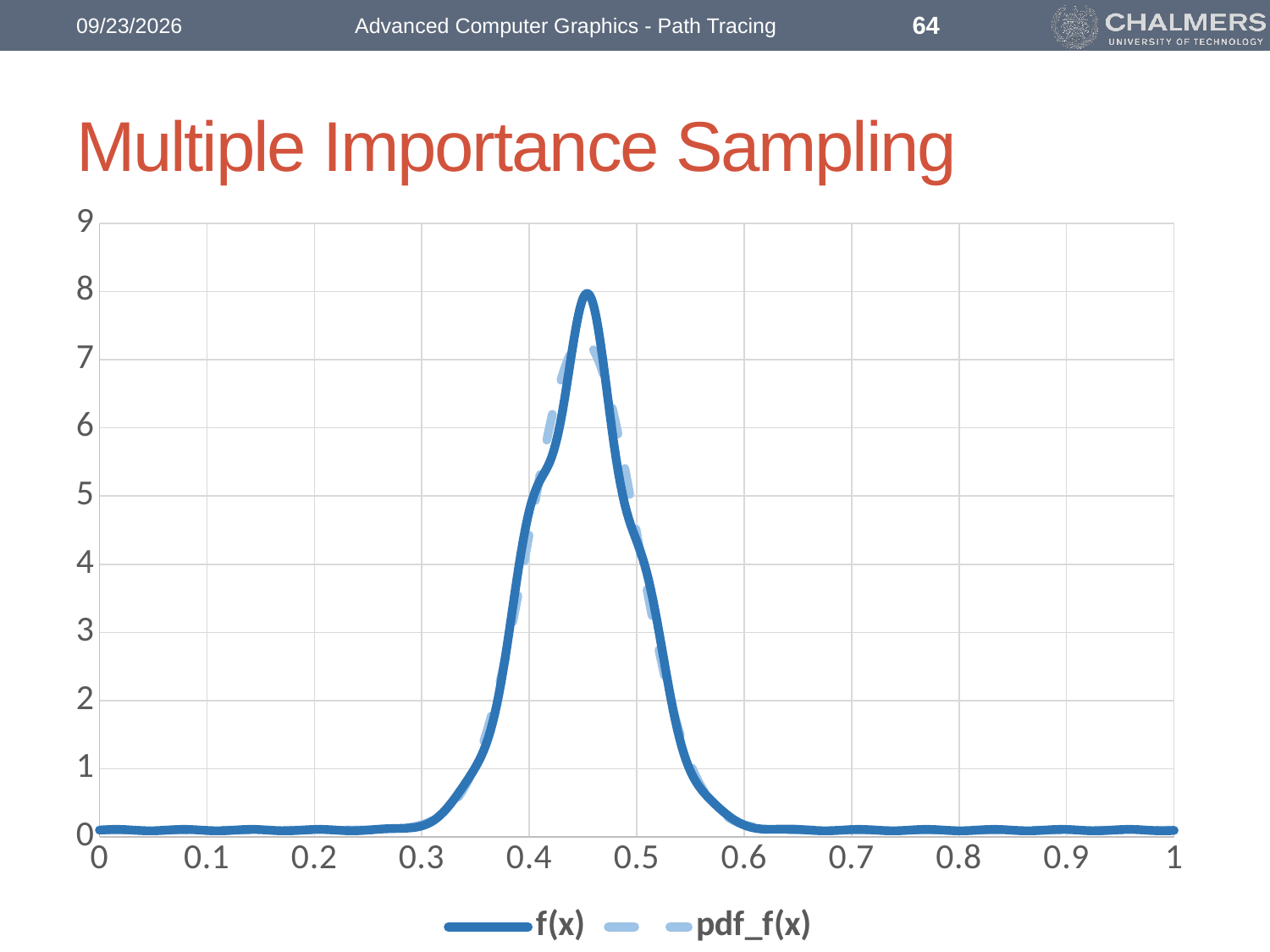
Is the value of f(x) at x = 0.4 greater or less than 3? greater Is the value of f(x) at x = 0.3 greater or less than 1? less Does the peak of f(x) reach above 7 on the y axis? yes What are the two series named in the legend? f(x) and pdf_f(x) What kind of chart is shown on the slide? line chart Between x = 0.3 and x = 0.45, does f(x) rise or fall? rise How many series does the legend list? 2 Which has the larger f(x) value, x = 0.3 or x = 0.4? x = 0.4 Between x = 0.5 and x = 0.6, does f(x) rise or fall? fall Which series is drawn with a dashed line? pdf_f(x)